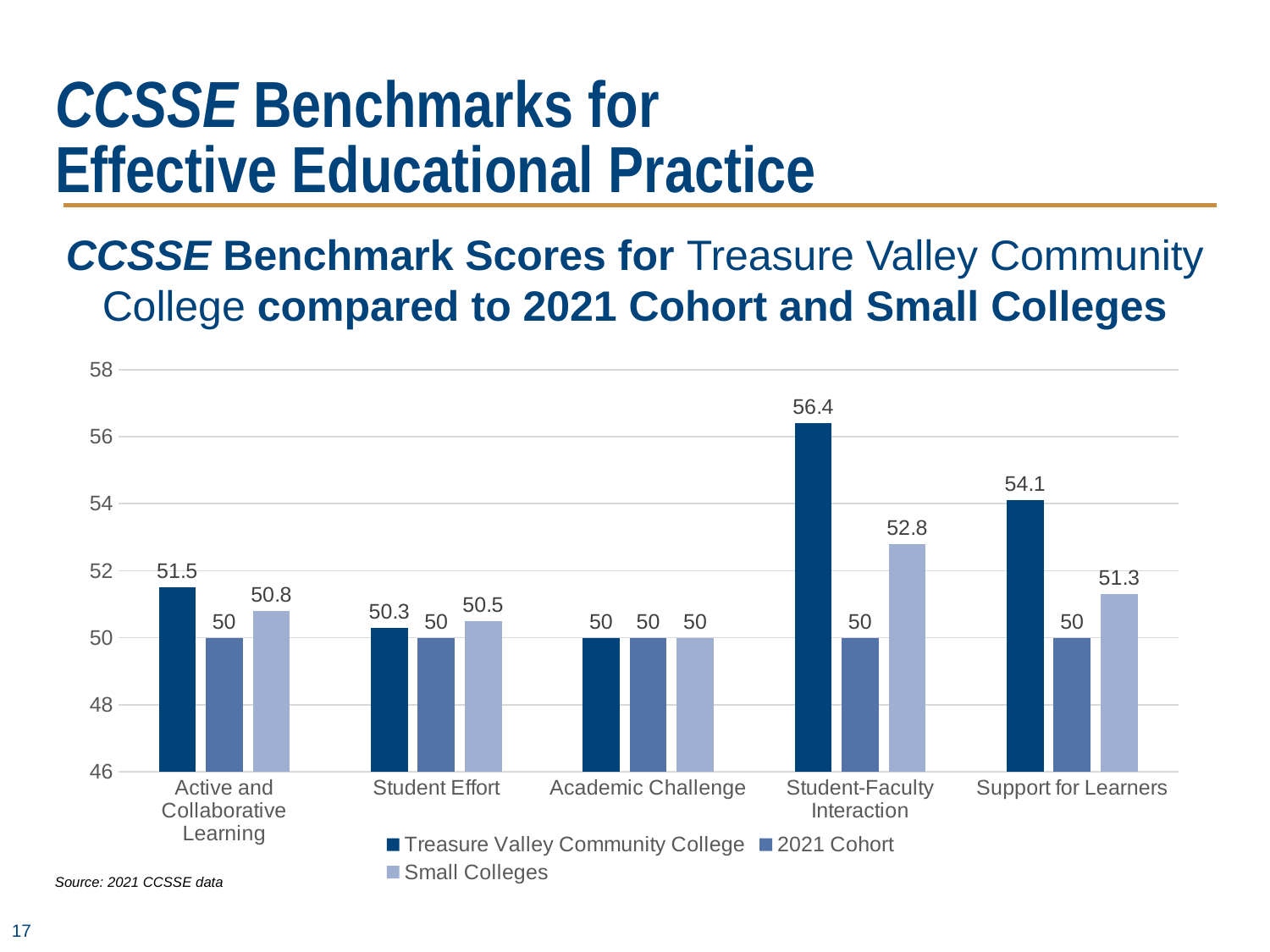
What kind of chart is shown on the slide? Bar chart For Student Effort, which is larger: the Treasure Valley Community College score or the Small Colleges score? Small Colleges What is the difference between the Treasure Valley Community College score and the Small Colleges score for Student-Faculty Interaction? 3.6 What is the Treasure Valley Community College score for Student-Faculty Interaction? 56.4 What is the difference between the Treasure Valley Community College score and the 2021 Cohort score for Support for Learners? 4.1 What is the 2021 Cohort score for every benchmark? 50 Which benchmark has the lowest Treasure Valley Community College score? Academic Challenge How many series does the legend list? 3 What is the Small Colleges score for Support for Learners? 51.3 Which benchmark has the highest Treasure Valley Community College score? Student-Faculty Interaction What is the Treasure Valley Community College score for Active and Collaborative Learning? 51.5 How many benchmark categories are shown on the x axis? 5